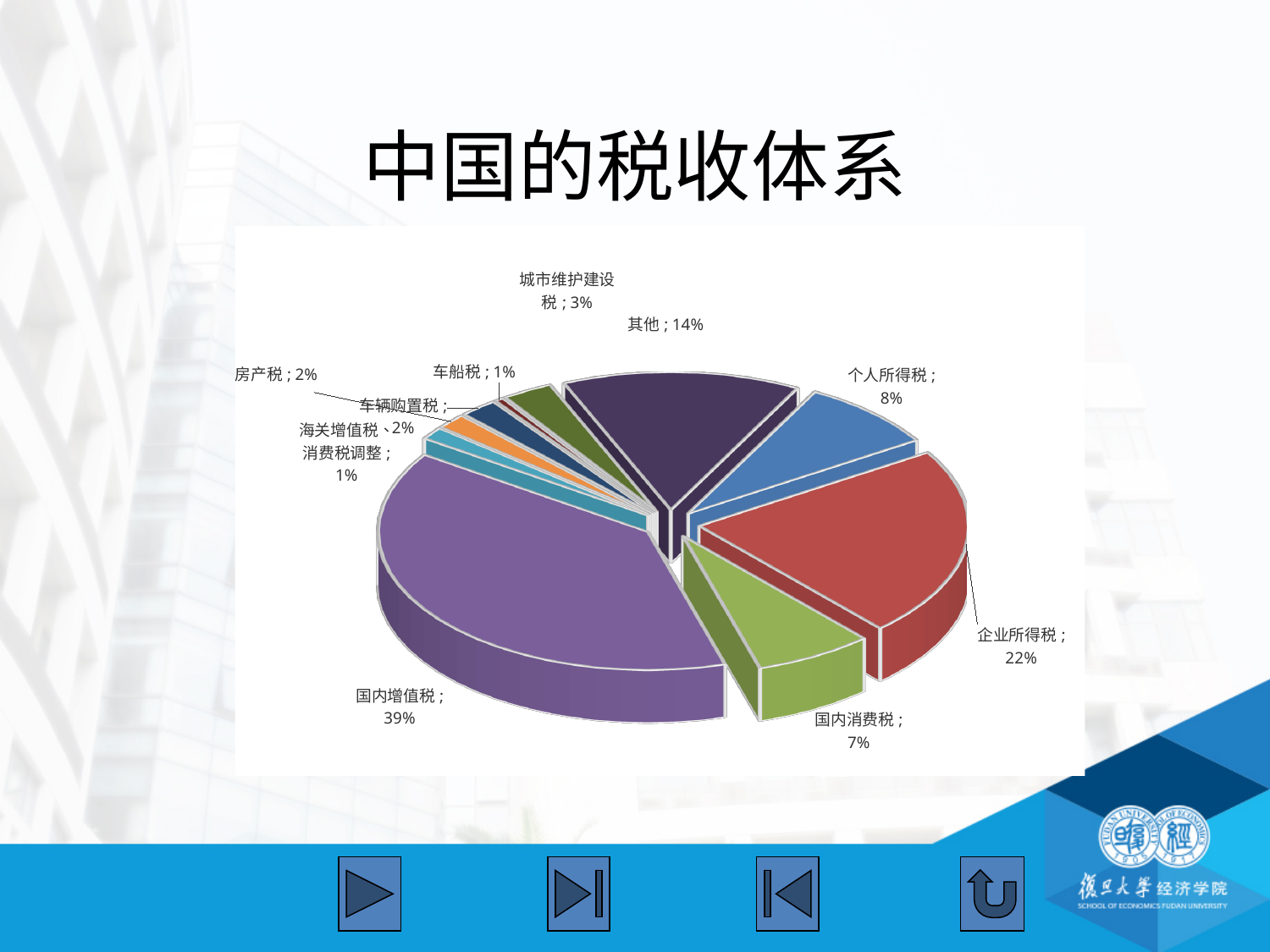
What is the value labelled for 个人所得税? 8% What type of chart is shown on the slide? Pie chart What is the difference in percentage points between 国内增值税 and 企业所得税? 17 What is the combined share of 国内增值税 and 国内消费税? 46% How many categories are shown in the pie chart? 10 What is the difference in percentage points between 个人所得税 and 国内消费税? 1 What is the title of the slide containing the chart? 中国的税收体系 What percentage is shown for 城市维护建设税? 3% Which is larger, the share for 其他 or the share for 个人所得税? 其他 What percentage is shown for 企业所得税? 22% Which category has the largest slice of the pie? 国内增值税 What share of the pie does 国内增值税 account for? 39%